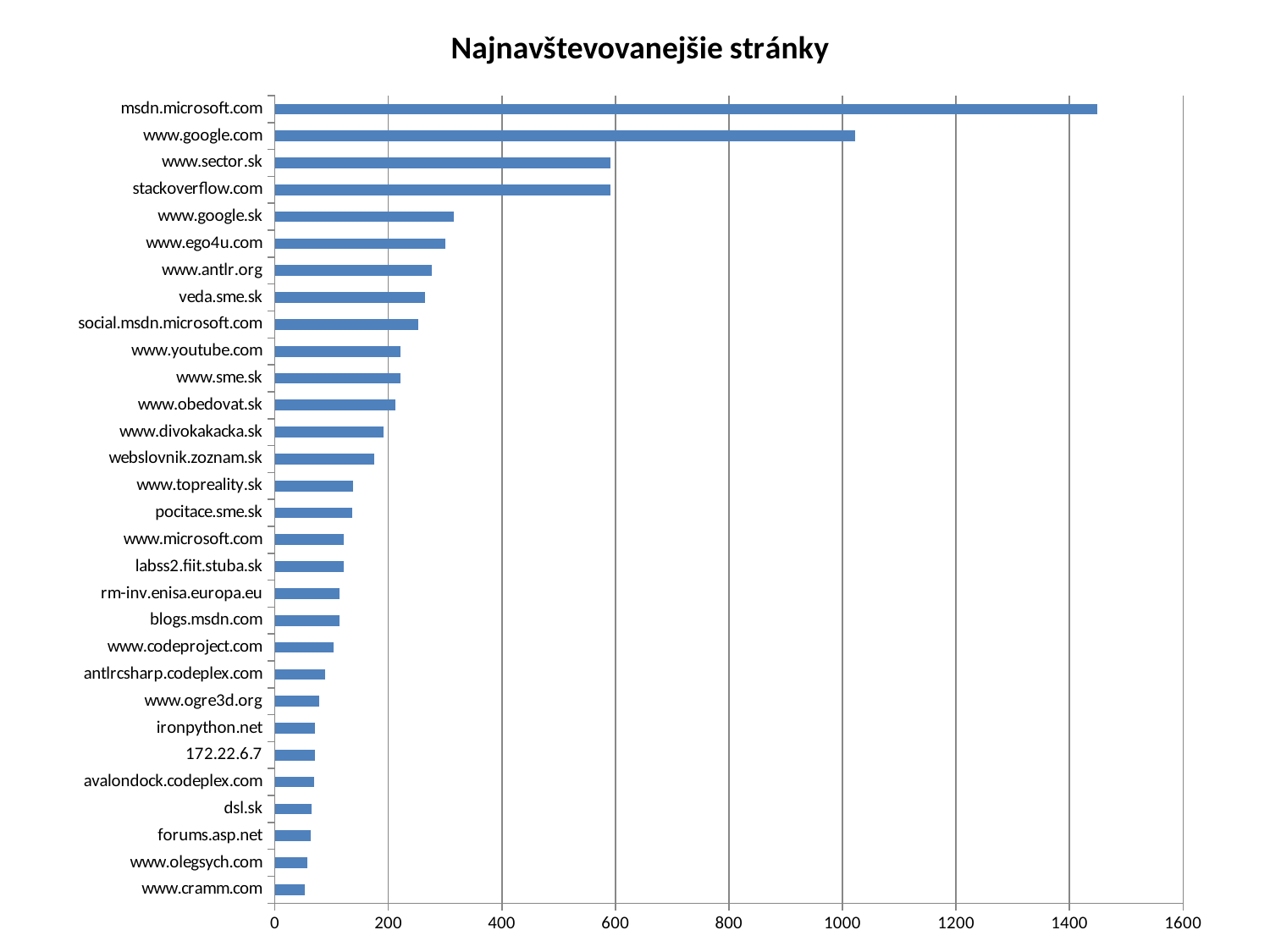
What type of chart is shown on the slide? bar chart Is the value for www.sector.sk greater or less than 400? greater What is the title of the chart? Najnavštevovanejšie stránky Is the value for msdn.microsoft.com greater or less than 1400? greater Which website has the highest value on the chart? msdn.microsoft.com Is the value for www.cramm.com greater or less than 200? less Which has a larger value, www.antlr.org or www.ogre3d.org? www.antlr.org How many websites are listed on the chart? 30 Which has a larger value, msdn.microsoft.com or www.google.com? msdn.microsoft.com